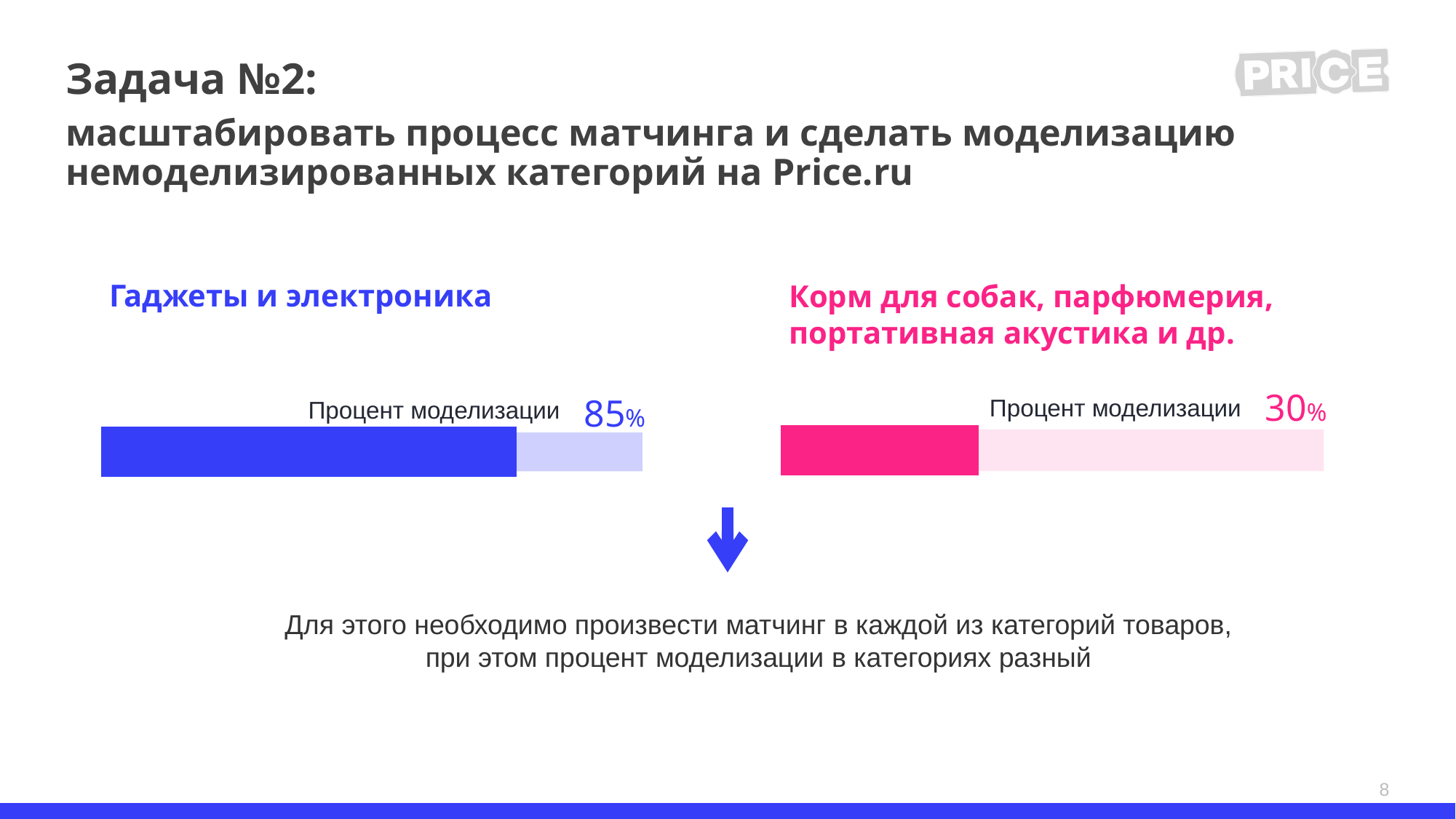
What is the difference in modelization percentage between Гаджеты и электроника and Корм для собак, парфюмерия, портативная акустика и др.? 55% What is the modelization percentage (Процент моделизации) shown for Корм для собак, парфюмерия, портативная акустика и др.? 30% Which category has the higher modelization percentage, Гаджеты и электроника or Корм для собак, парфюмерия, портативная акустика и др.? Гаджеты и электроника Which of the two categories shown has the lowest modelization percentage? Корм для собак, парфюмерия, портативная акустика и др. Is the modelization percentage for Корм для собак, парфюмерия, портативная акустика и др. greater or less than 50%? less What kind of chart is used to show the modelization percentages on the slide? bar chart Is the modelization percentage for Гаджеты и электроника greater or less than 50%? greater What colour is the bar for Корм для собак, парфюмерия, портативная акустика и др.? pink What is the modelization percentage (Процент моделизации) shown for Гаджеты и электроника? 85% What colour is the bar for Гаджеты и электроника? blue How many product categories have a modelization percentage bar on the slide? 2 Which of the two categories shown has the highest modelization percentage? Гаджеты и электроника